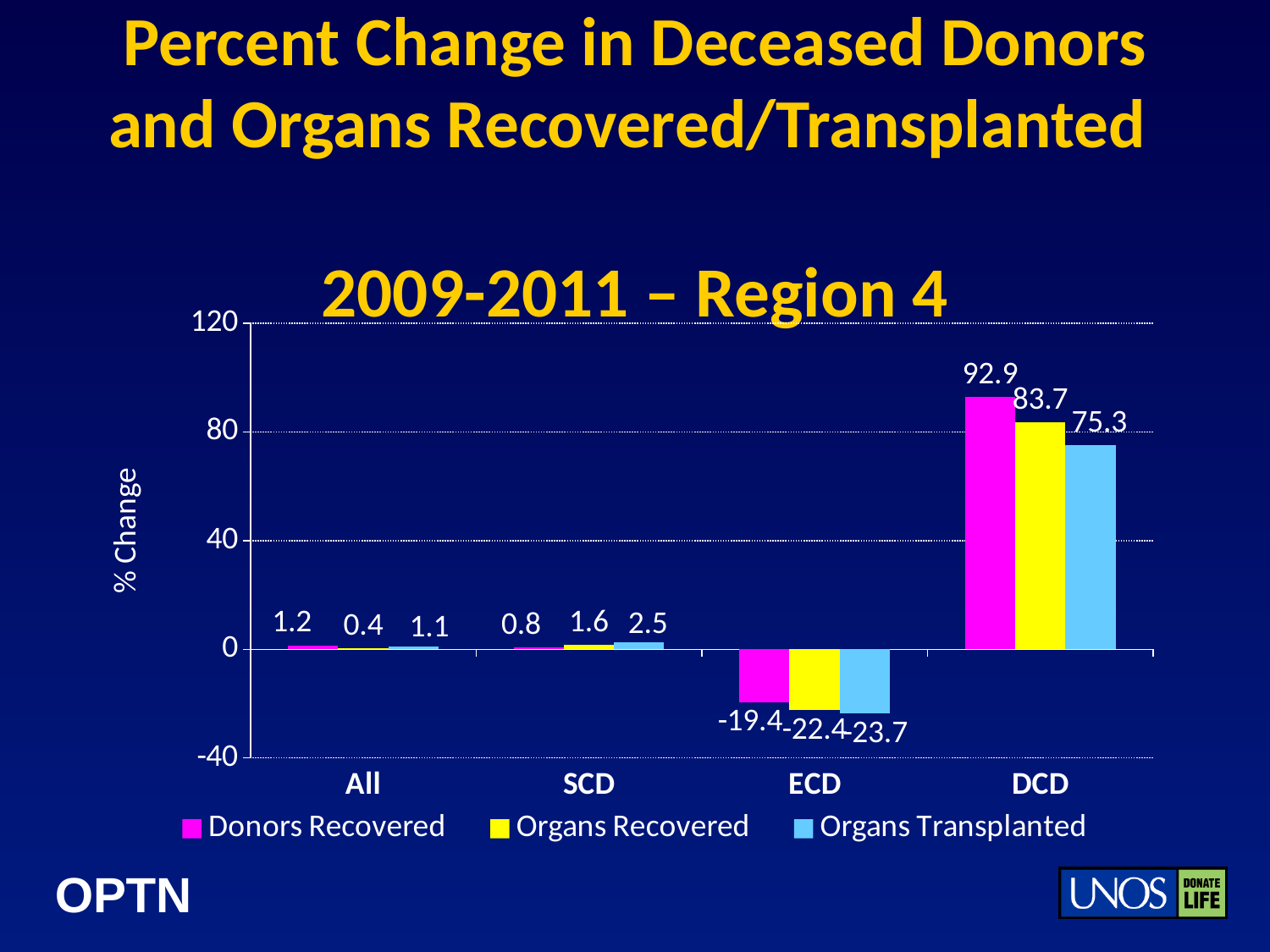
What is the Donors Recovered value for All? 1.2 For SCD, which is larger: Organs Transplanted or Donors Recovered? Organs Transplanted What is the Organs Recovered value for SCD? 1.6 How many categories are shown on the x axis? 4 What is the difference between the Donors Recovered and Organs Transplanted values for DCD? 17.6 What is the label of the y axis? % Change How many series does the legend list? 3 What is the Donors Recovered value for DCD? 92.9 What is the Organs Transplanted value for ECD? -23.7 Which category has the lowest Donors Recovered value? ECD Which category has the highest Organs Recovered value? DCD What kind of chart is shown on the slide? bar chart